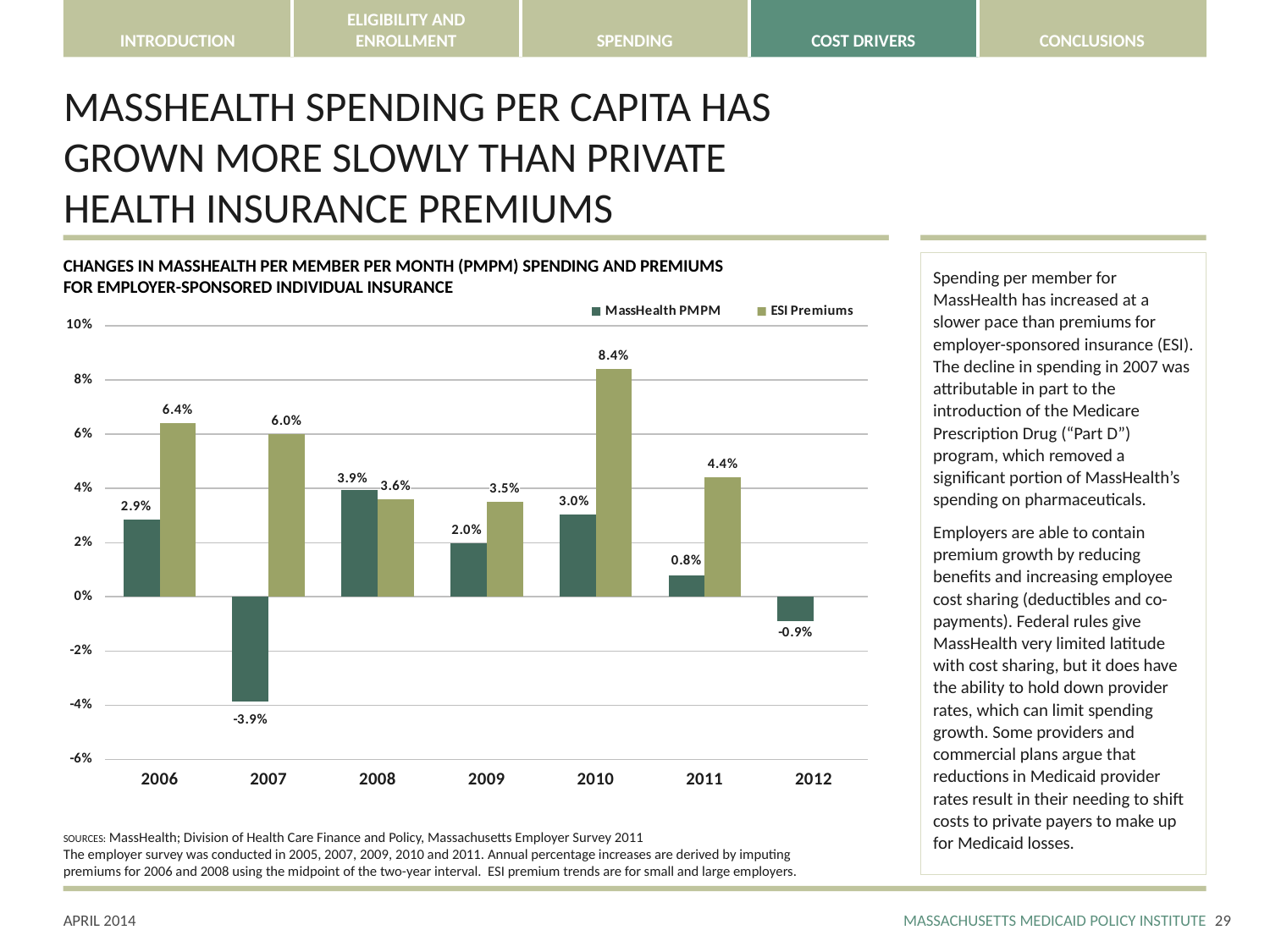
Which was larger in 2008, the MassHealth PMPM change or the ESI Premiums change? MassHealth PMPM What is the difference between the ESI Premiums change and the MassHealth PMPM change in 2006? 3.5% In which year was the MassHealth PMPM change the lowest? 2007 How many series does the legend list? 2 Is the ESI Premiums value for 2011 greater or less than 4%? greater What kind of chart is shown? Bar chart In which year was the ESI Premiums change the highest? 2010 What was the MassHealth PMPM change in 2007? -3.9% Which series is shown in the darker green colour? MassHealth PMPM How many years are shown on the x axis? 7 What was the MassHealth PMPM change in 2012? -0.9% What was the ESI Premiums change in 2010? 8.4%